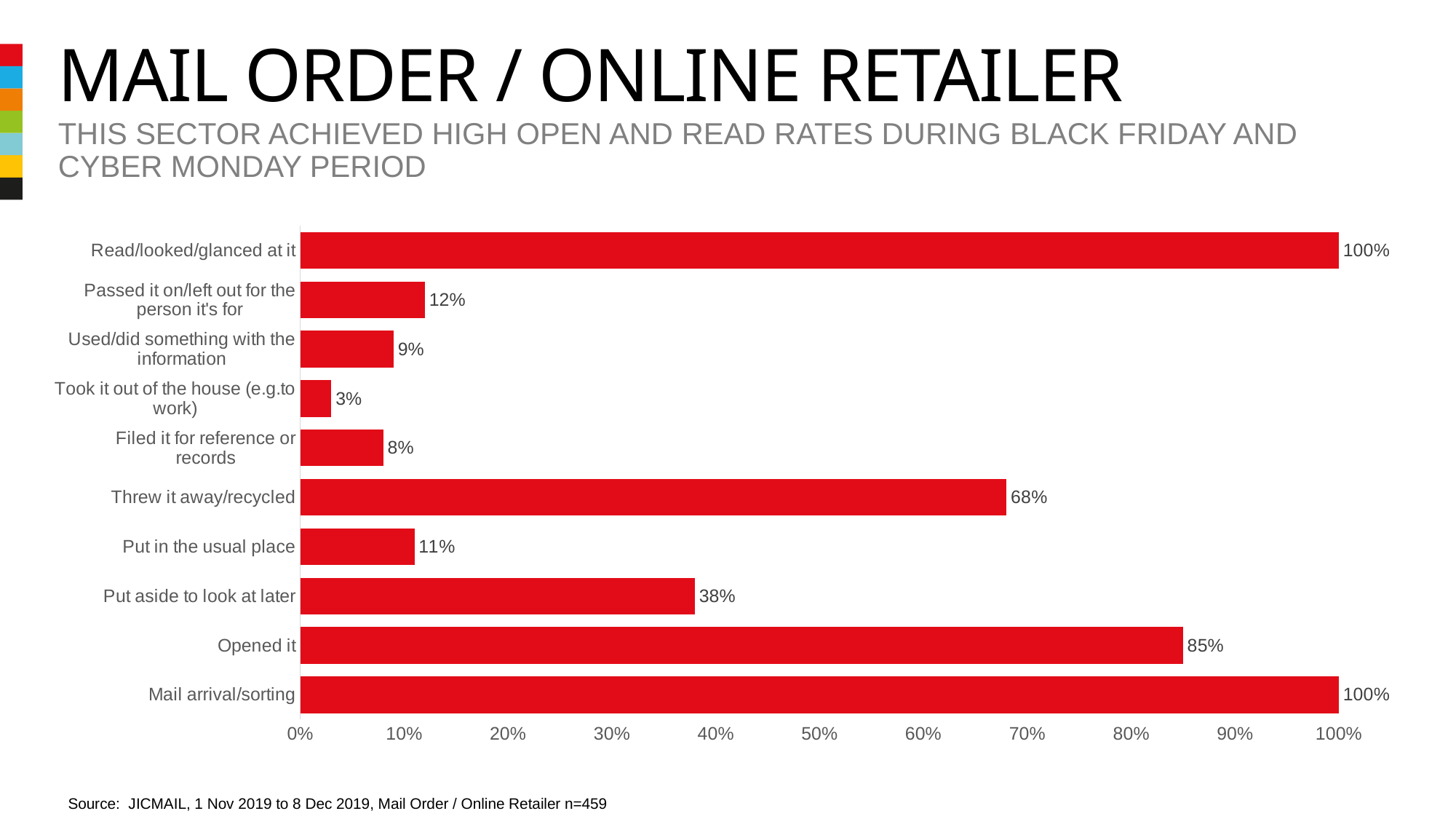
What is the sample size (n) given in the source note? 459 What is the difference between the values for "Passed it on/left out for the person it's for" and "Filed it for reference or records"? 4% What is the value for "Put aside to look at later"? 38% What kind of chart is shown on the slide? Bar chart How many categories are shown in the chart? 10 Which category has the lowest value? Took it out of the house (e.g.to work) What is the value for "Took it out of the house (e.g.to work)"? 3% What is the value for "Opened it"? 85% What is the difference between the values for "Opened it" and "Threw it away/recycled"? 17% What is the value for "Threw it away/recycled"? 68% Which is larger, the value for "Put in the usual place" or the value for "Put aside to look at later"? Put aside to look at later Is the value for "Threw it away/recycled" greater or less than 60%? greater